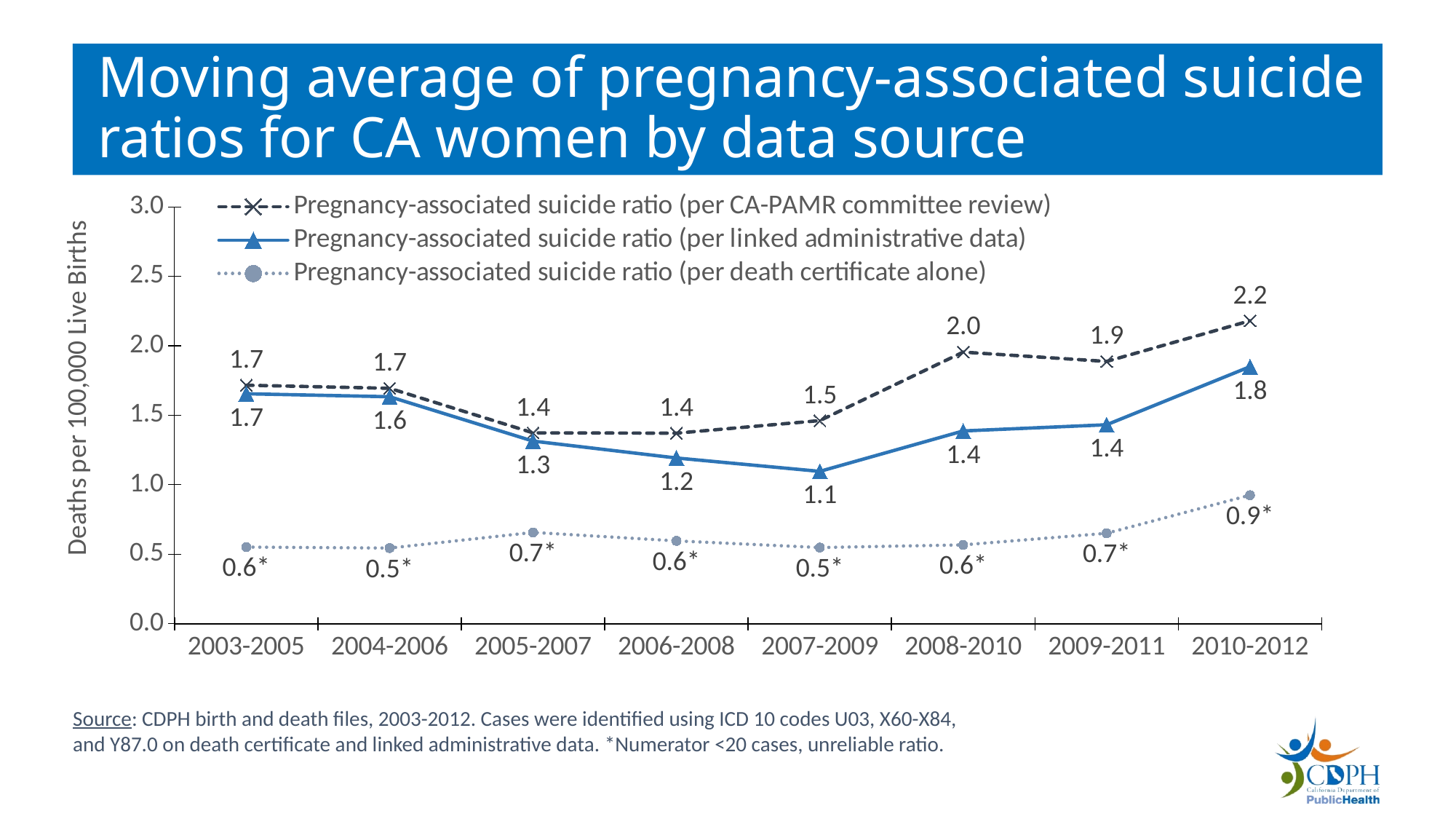
What is the label of the y axis? Deaths per 100,000 Live Births What is the pregnancy-associated suicide ratio per linked administrative data for 2007-2009? 1.1 What is the difference between the CA-PAMR committee review ratio and the linked administrative data ratio for 2007-2009? 0.4 In which period is the pregnancy-associated suicide ratio per CA-PAMR committee review highest? 2010-2012 In which period is the pregnancy-associated suicide ratio per linked administrative data lowest? 2007-2009 What kind of chart is shown on the slide? Line chart What is the pregnancy-associated suicide ratio per CA-PAMR committee review for 2010-2012? 2.2 Is the pregnancy-associated suicide ratio per death certificate alone for 2005-2007 greater or less than 1.0? less How many series does the legend list? 3 What is the pregnancy-associated suicide ratio per death certificate alone for 2010-2012? 0.9* How many time periods are shown on the x axis? 8 For 2008-2010, which is larger: the ratio per CA-PAMR committee review or the ratio per linked administrative data? Pregnancy-associated suicide ratio (per CA-PAMR committee review)